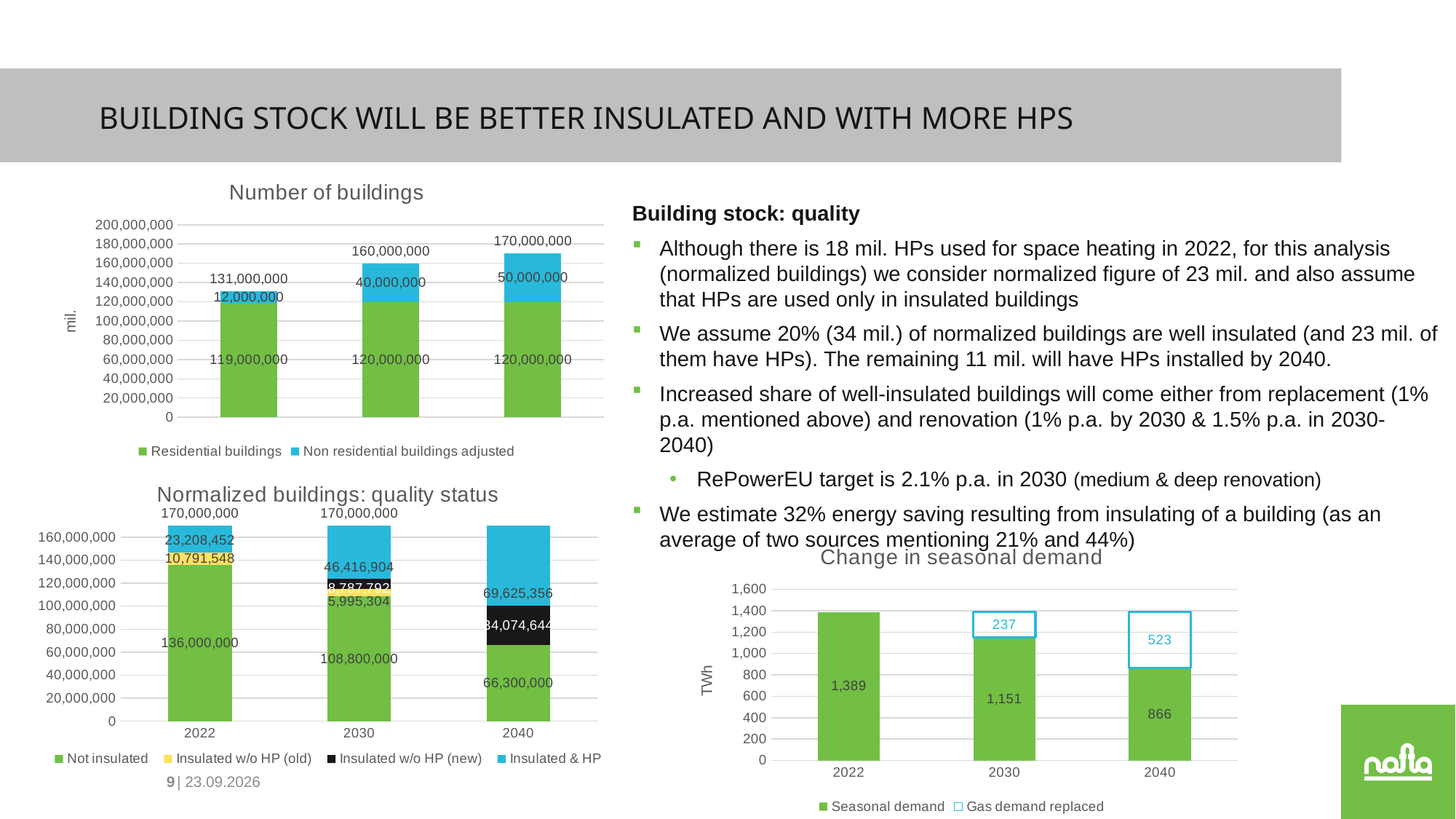
In the 'Change in seasonal demand' chart, what is the difference between the seasonal demand in 2022 and in 2040? 523 In the 'Change in seasonal demand' chart, what is the total of the stacked bar for 2030? 1,388 In the 'Change in seasonal demand' chart, does the seasonal demand rise or fall from 2022 to 2040? fall In the 'Number of buildings' chart, what is the difference between the total of the second bar and the total of the first bar? 29,000,000 In the 'Number of buildings' chart, what is the 'Non residential buildings adjusted' value for the third bar? 50,000,000 In the 'Change in seasonal demand' chart, what is the seasonal demand value for 2022? 1,389 How many series does the legend of the 'Normalized buildings: quality status' chart list? 4 In the 'Normalized buildings: quality status' chart, which year has the lowest 'Not insulated' value? 2040 What type of chart is the 'Number of buildings' chart? stacked bar chart In the 'Normalized buildings: quality status' chart, what is the value for 'Insulated & HP' in 2040? 69,625,356 In the 'Normalized buildings: quality status' chart, what is the value for 'Not insulated' in 2030? 108,800,000 In the 'Change in seasonal demand' chart, what is the gas demand replaced value for 2040? 523